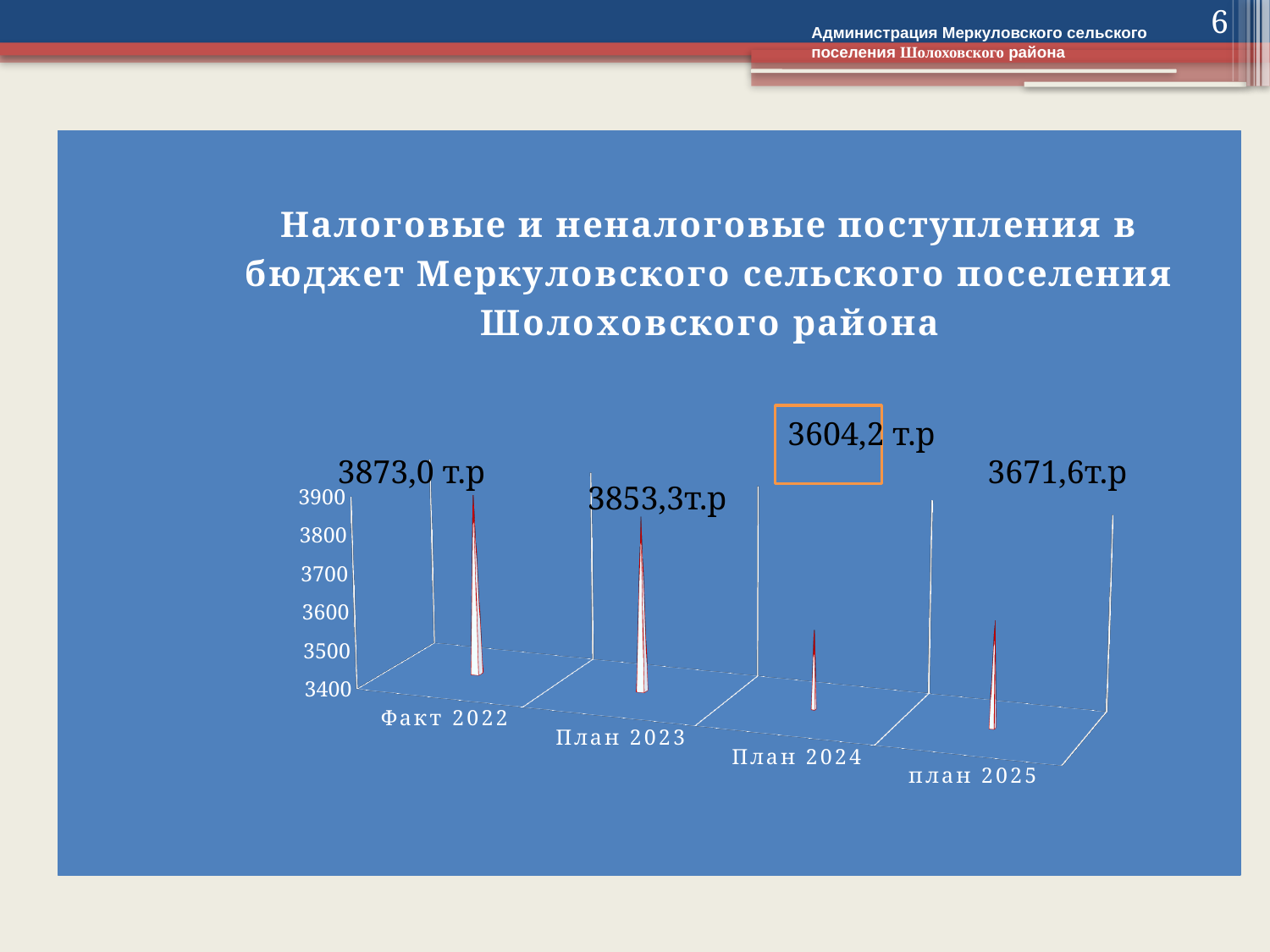
What is the value for План 2023? 3853,3т.р What is the value for план 2025? 3671,6т.р Which category has the lowest value? План 2024 What is the value for Факт 2022? 3873,0 т.р What is the difference between the values for план 2025 and План 2024? 67,4 т.р What is the value for План 2024? 3604,2 т.р What is the difference between the values for Факт 2022 and План 2024? 268,8 т.р Which is larger, the value for План 2023 or the value for план 2025? План 2023 Which category has the highest value? Факт 2022 What kind of chart is this? Bar chart Which category's data label is highlighted with an orange box? План 2024 How many categories are shown on the x axis? 4